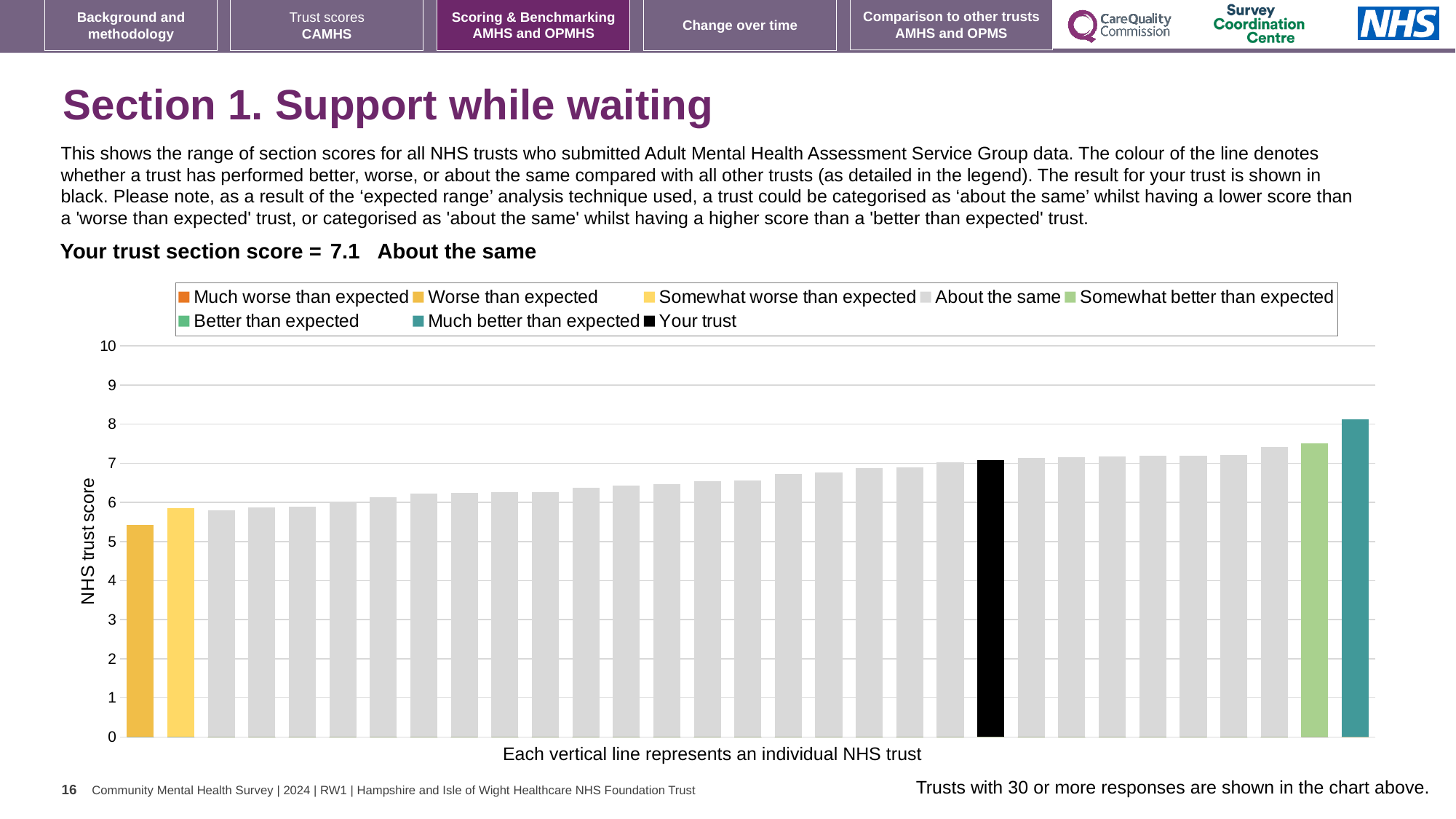
What is the highest value shown on the vertical axis? 10 Is the value of the black 'Your trust' bar greater or less than 7? greater Is the value of the lowest bar in the chart greater or less than 6? less What kind of chart is shown on the slide? bar chart Is the value of the lowest bar in the chart greater or less than 5? greater Which legend category does the tallest bar in the chart belong to? Much better than expected How many entries does the chart legend list? 8 Do the bar values rise or fall from left to right across the chart? rise What is the label on the vertical axis of the chart? NHS trust score Which is larger: the black 'Your trust' bar or the teal 'Much better than expected' bar? Much better than expected What is the section score for 'Your trust' shown on the slide? 7.1 How many bars in the chart are coloured as 'Somewhat better than expected'? 1